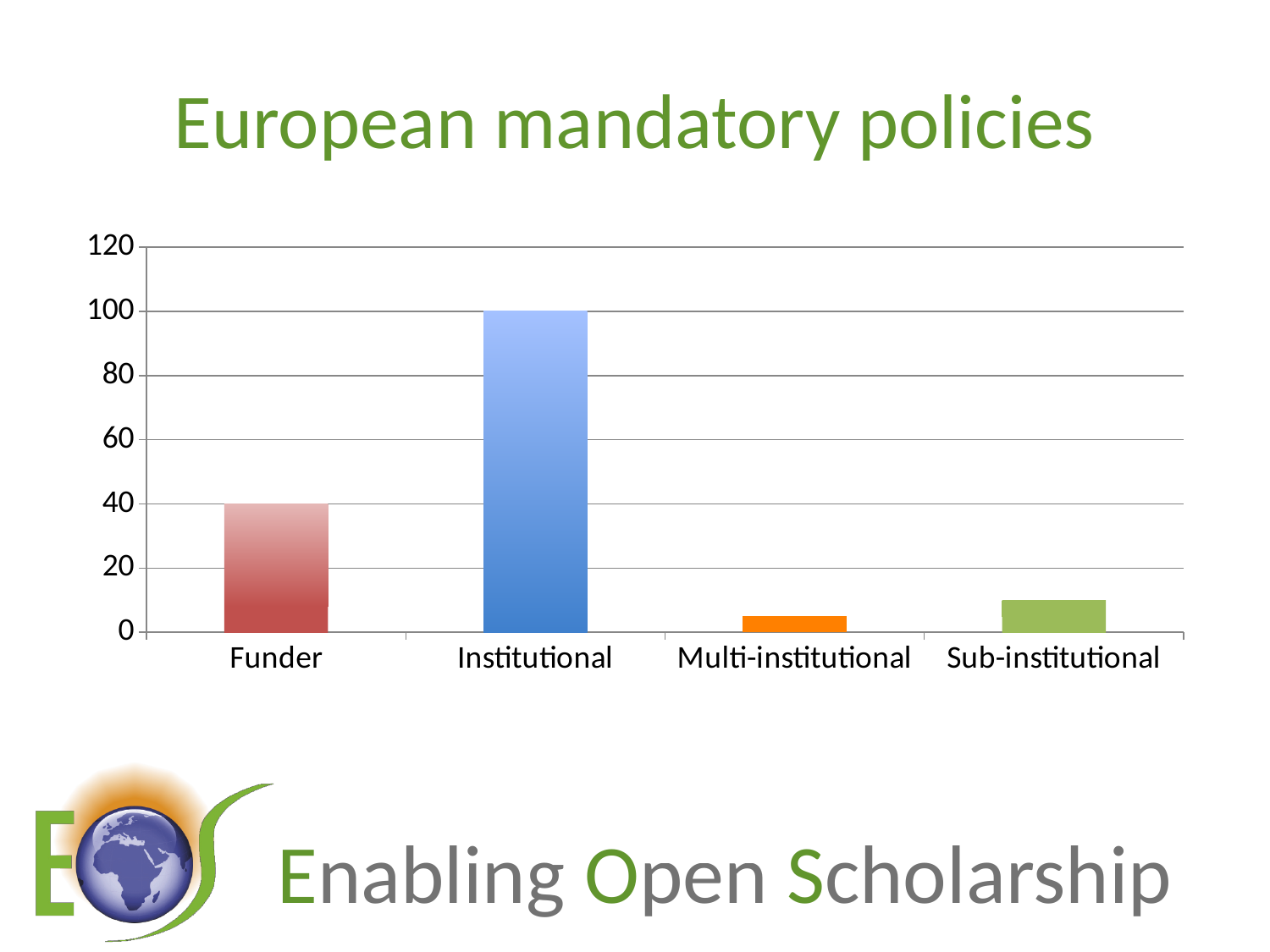
Which is larger, the value for Sub-institutional or the value for Multi-institutional? Sub-institutional What is the title of the chart? European mandatory policies What is the value for Institutional? 100 Which category has the highest value? Institutional How many categories are shown on the x axis? 4 Is the value for Multi-institutional greater or less than 20? less What is the highest value shown on the y axis? 120 What is the value for Funder? 40 Is the value for Sub-institutional greater or less than 20? less What type of chart is shown on the slide? bar chart Which category has the lowest value? Multi-institutional What is the difference between the values for Institutional and Funder? 60